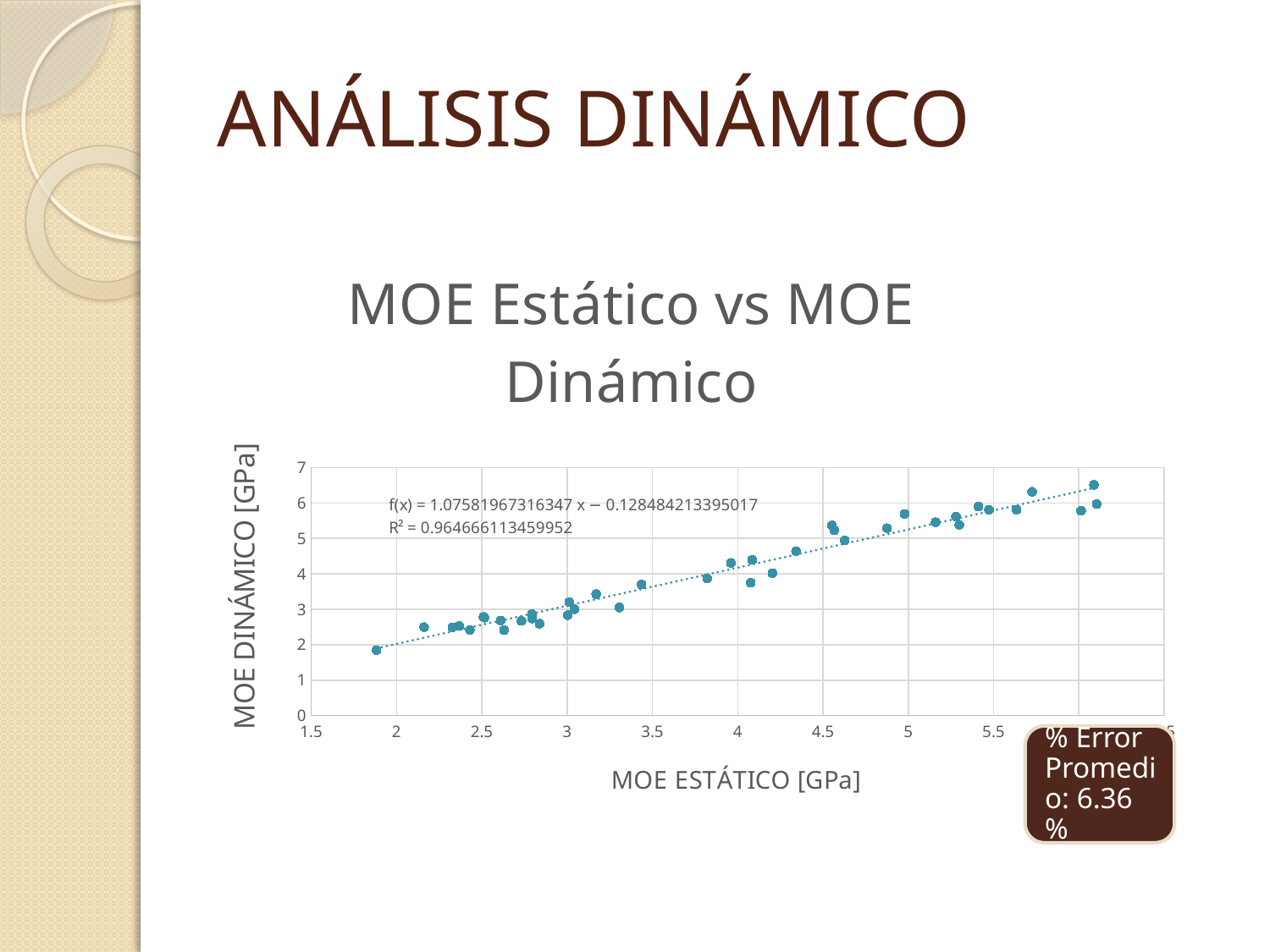
What percentage is given as the average error (% Error Promedio) on the slide? 6.36 % What is the slope of the fitted line f(x) printed on the chart? 1.07581967316347 What is the label of the horizontal axis of the chart? MOE ESTÁTICO [GPa] What is the lowest tick value shown on the horizontal axis? 1.5 What is the intercept term in the fitted line equation printed on the chart? −0.128484213395017 What is the title of the chart? MOE Estático vs MOE Dinámico Is the MOE Dinámico value of the point with the lowest MOE Estático greater or less than 3? less Do the plotted points generally rise or fall as MOE Estático increases? rise What R² value is printed on the chart? 0.964666113459952 What is the highest tick value shown on the vertical axis? 7 What kind of chart is shown on the slide? scatter chart